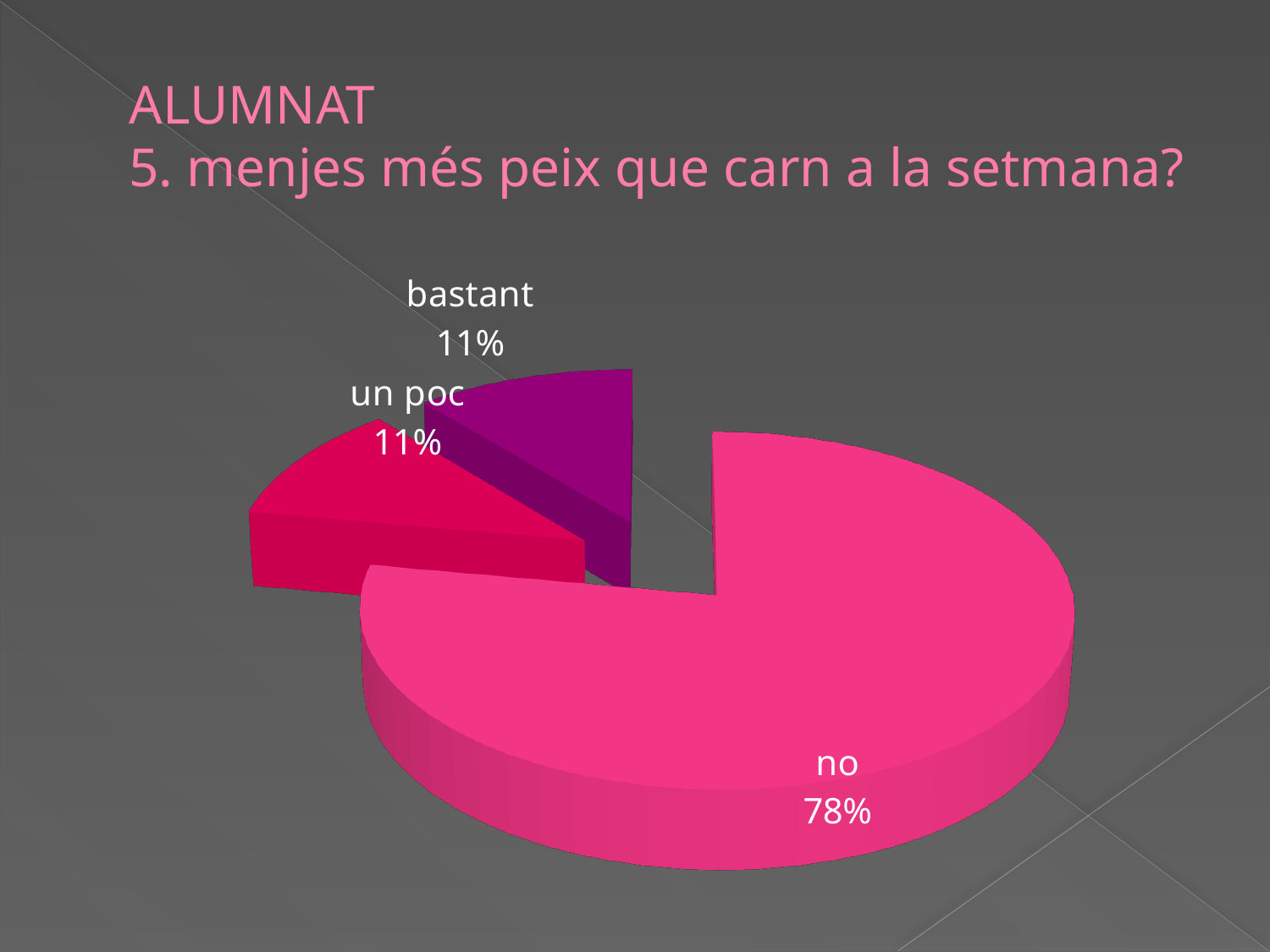
Which category has the largest slice of the pie chart? no What percentage of the pie chart is labelled "no"? 78% How many slices does the pie chart have? 3 What percentage of the pie chart is labelled "bastant"? 11% What question is shown as the title above the pie chart? 5. menjes més peix que carn a la setmana? Which is larger, the "no" slice or the "un poc" slice? no What is the combined share of the "bastant" and "un poc" slices? 22% What percentage of the pie chart is labelled "un poc"? 11% What is the difference in percentage points between the "no" slice and the "bastant" slice? 67 Which slice of the pie chart is coloured purple? bastant What kind of chart is shown on the slide? pie chart Is the share for "no" greater or less than 50%? greater